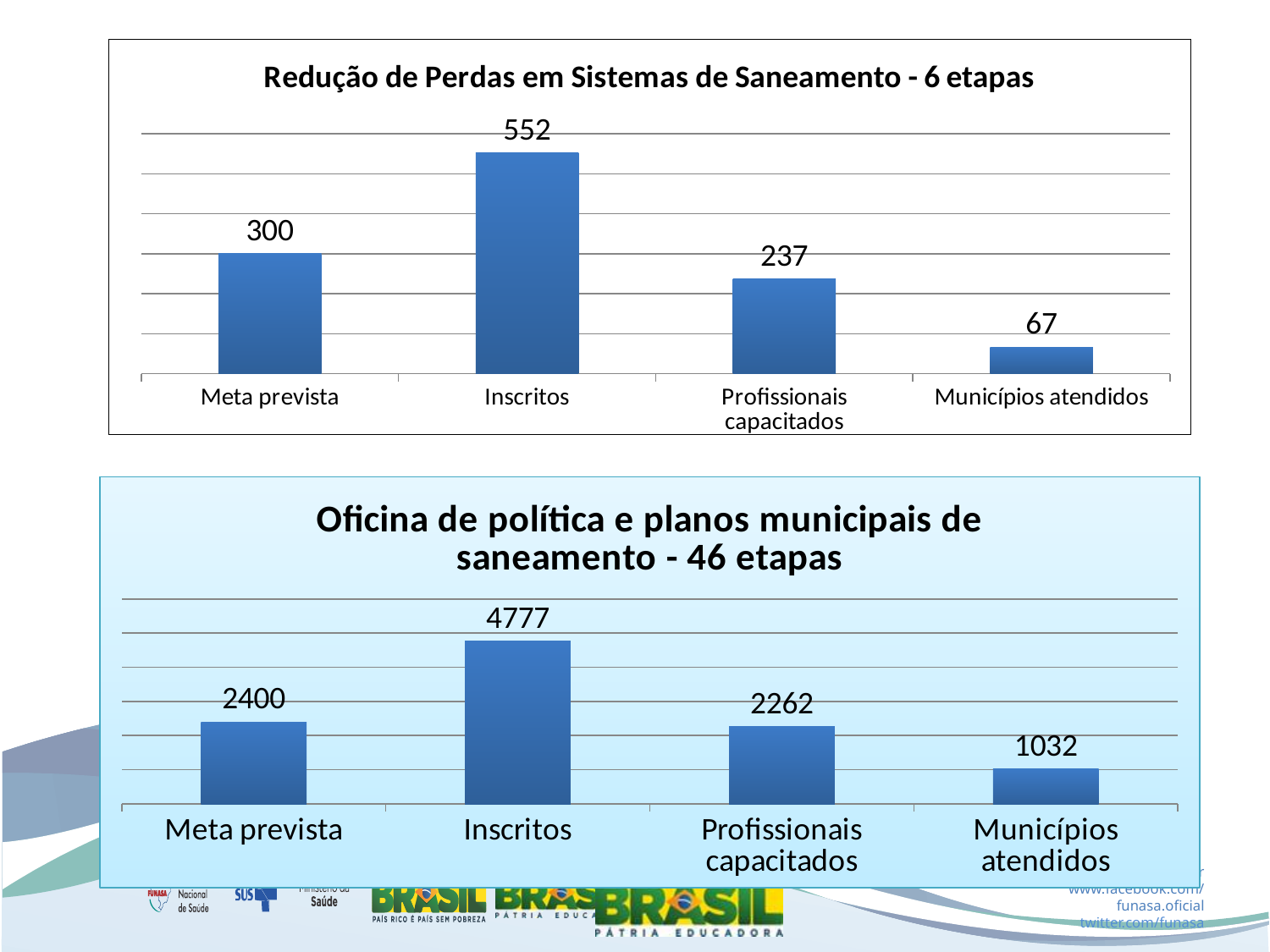
In the top chart 'Redução de Perdas em Sistemas de Saneamento - 6 etapas', what is the difference between Inscritos and Meta prevista? 252 In the bottom chart 'Oficina de política e planos municipais de saneamento - 46 etapas', which is larger: Meta prevista or Profissionais capacitados? Meta prevista In the top chart 'Redução de Perdas em Sistemas de Saneamento - 6 etapas', what is the value for Inscritos? 552 What is the title of the top chart on the slide? Redução de Perdas em Sistemas de Saneamento - 6 etapas In the bottom chart 'Oficina de política e planos municipais de saneamento - 46 etapas', what is the value for Profissionais capacitados? 2262 In the top chart 'Redução de Perdas em Sistemas de Saneamento - 6 etapas', how many categories are shown? 4 In the bottom chart 'Oficina de política e planos municipais de saneamento - 46 etapas', which category has the lowest value? Municípios atendidos In the top chart 'Redução de Perdas em Sistemas de Saneamento - 6 etapas', which category has the highest value? Inscritos In the top chart 'Redução de Perdas em Sistemas de Saneamento - 6 etapas', what is the value for Municípios atendidos? 67 What kind of chart is the bottom chart 'Oficina de política e planos municipais de saneamento - 46 etapas'? Bar chart In the bottom chart 'Oficina de política e planos municipais de saneamento - 46 etapas', what is the value for Meta prevista? 2400 In the bottom chart 'Oficina de política e planos municipais de saneamento - 46 etapas', what is the difference between Inscritos and Municípios atendidos? 3745